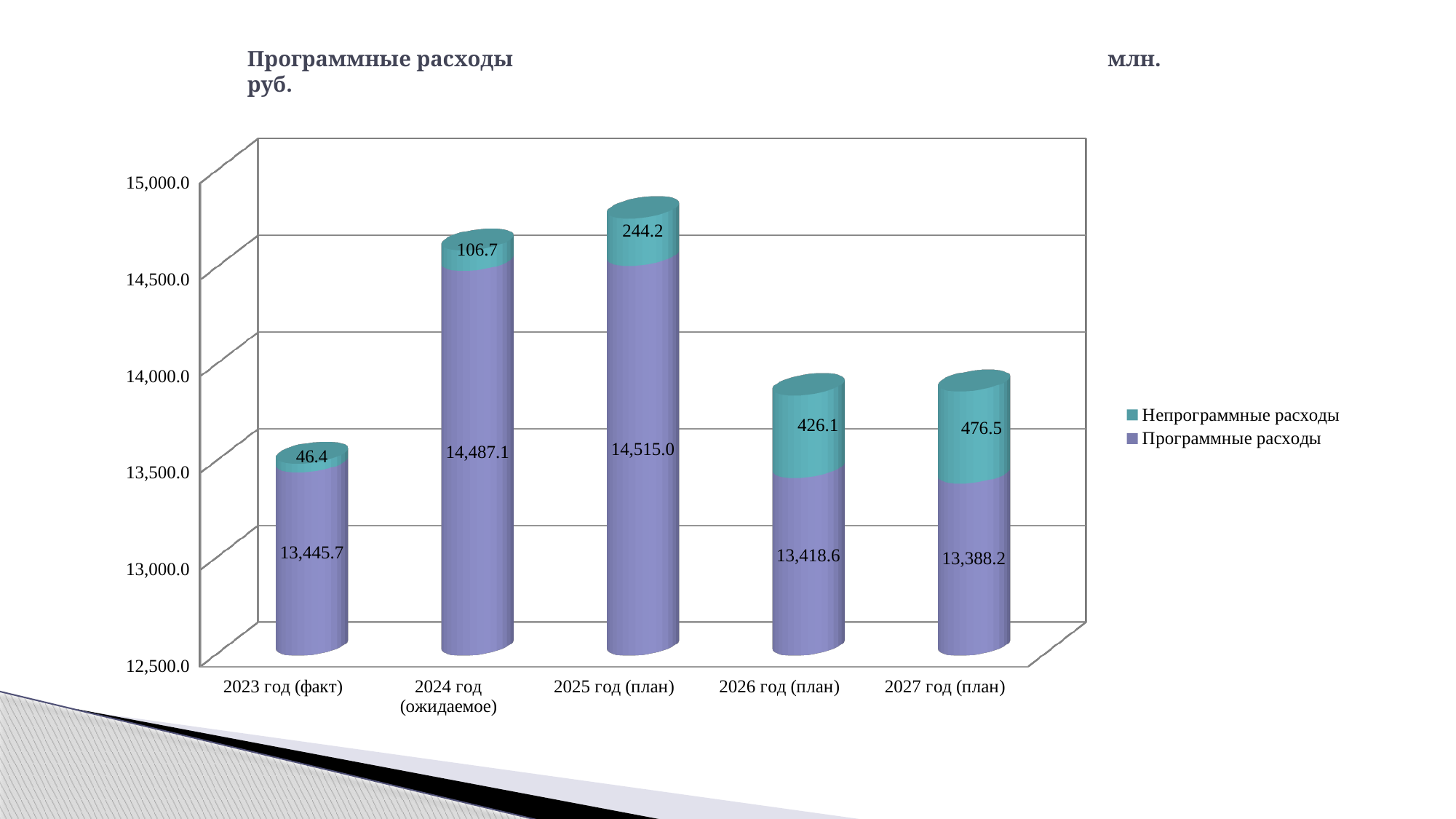
What kind of chart is shown on the slide? Stacked bar chart What is the value of Непрограммные расходы for 2026 год (план)? 426.1 What is the difference between Непрограммные расходы for 2027 год (план) and 2026 год (план)? 50.4 Which category has the highest value of Программные расходы? 2025 год (план) What is the total of the stacked bar for 2023 год (факт)? 13,492.1 Which category has the lowest value of Непрограммные расходы? 2023 год (факт) How many series does the legend list? 2 Is the total height of the bar for 2025 год (план) greater or less than 14,500.0? greater Which is larger: Программные расходы for 2026 год (план) or for 2027 год (план)? 2026 год (план) What is the value of Программные расходы for 2024 год (ожидаемое)? 14,487.1 How many categories are shown on the x axis? 5 Do the values of Непрограммные расходы rise or fall from 2023 год (факт) to 2027 год (план)? Rise